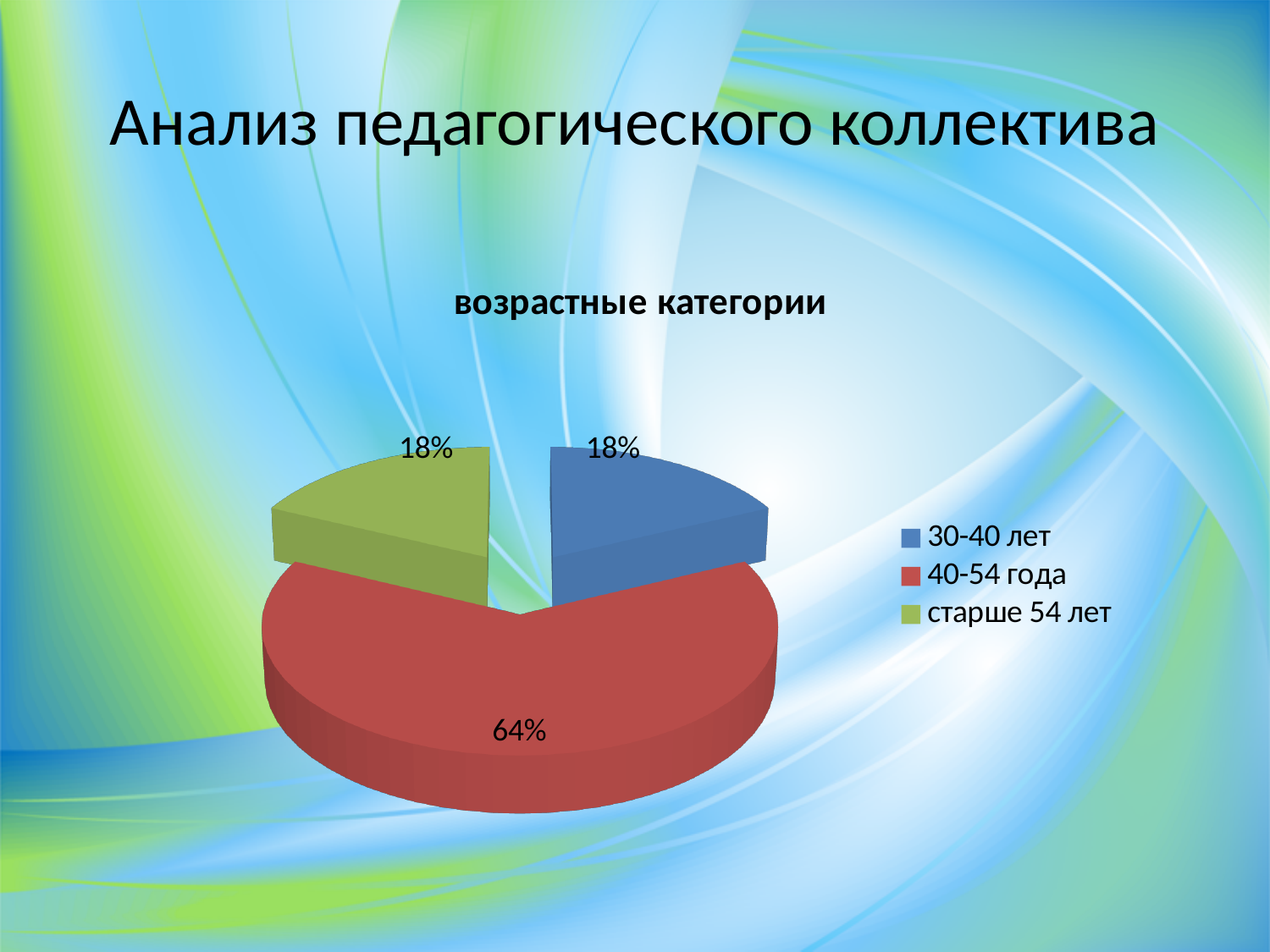
What is the difference in percentage points between the 40-54 года slice and the 30-40 лет slice? 46 What is the title of the chart? возрастные категории Do the 30-40 лет and старше 54 лет slices have the same share? Yes What share of the pie does the 40-54 года slice represent? 64% What share of the pie does the 30-40 лет slice represent? 18% How many slices does the pie chart have? 3 What kind of chart is shown on the slide? Pie chart Which age category has the largest share of the pie? 40-54 года Which is larger, the share for 40-54 года or the share for старше 54 лет? 40-54 года What share of the pie does the старше 54 лет slice represent? 18% Which colour represents the 40-54 года category in the legend? Red